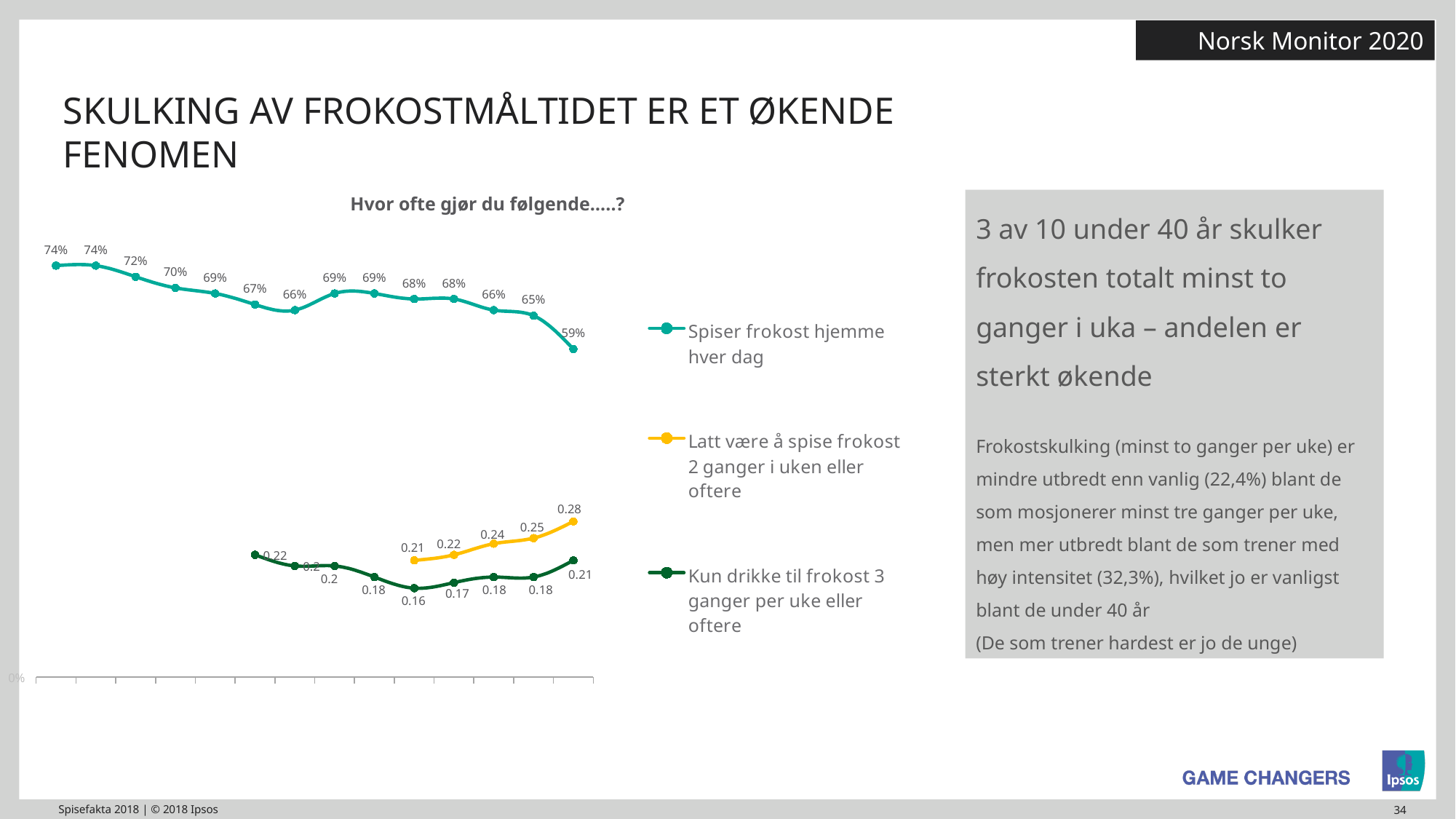
Does the line for 'Spiser frokost hjemme hver dag' generally rise or fall from left to right? Fall How many data points are plotted for the series 'Spiser frokost hjemme hver dag'? 14 What is the lowest value shown for 'Kun drikke til frokost 3 ganger per uke eller oftere'? 0.16 What is the highest value shown for 'Spiser frokost hjemme hver dag'? 74% What is the title of the chart? Hvor ofte gjør du følgende.....? Does the line for 'Latt være å spise frokost 2 ganger i uken eller oftere' rise or fall from left to right? Rise What is the lowest value shown for 'Spiser frokost hjemme hver dag'? 59% How many series does the legend list? 3 What is the difference between the first value (74%) and the last value (59%) of 'Spiser frokost hjemme hver dag'? 15 percentage points What is the last (rightmost) value shown for 'Latt være å spise frokost 2 ganger i uken eller oftere'? 0.28 What is the first (leftmost) value shown for 'Latt være å spise frokost 2 ganger i uken eller oftere'? 0.21 What kind of chart is shown on the slide? Line chart